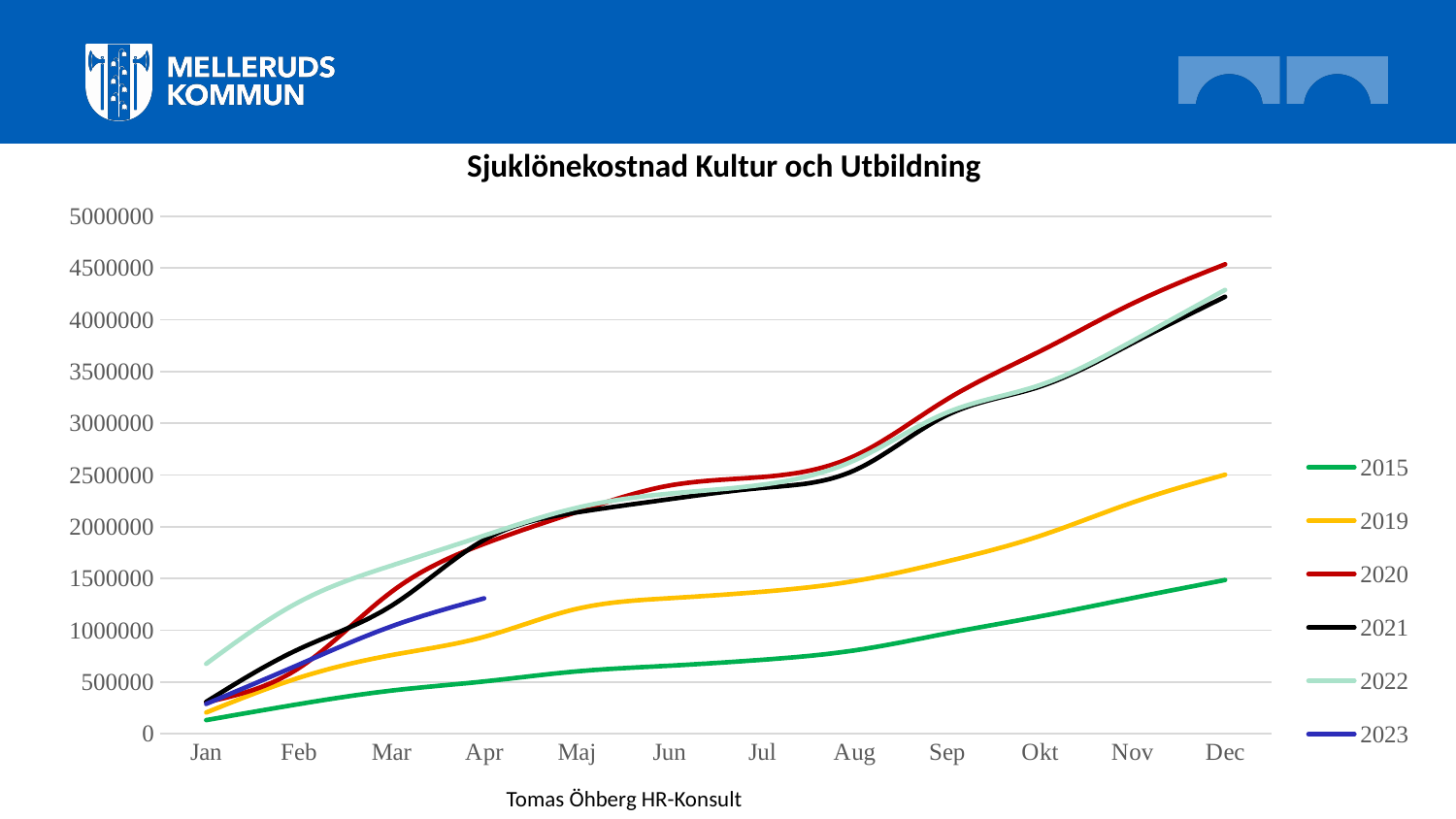
How many months are shown along the x axis? 12 Is the value for 2020 in Dec greater or less than 4000000? greater What kind of chart is shown on the slide? line chart What is the title of the chart? Sjuklönekostnad Kultur och Utbildning Which series in the legend is drawn in blue? 2023 Which series has the lowest value in Dec? 2015 Which is larger in Dec, the value for 2019 or the value for 2015? 2019 Is the value for 2023 in Apr greater or less than 1500000? less Do the values for the 2019 series rise or fall from Jan to Dec? rise Which series has the highest value in Dec? 2020 Is the value for 2015 in Dec greater or less than 1000000? greater How many series does the legend list? 6